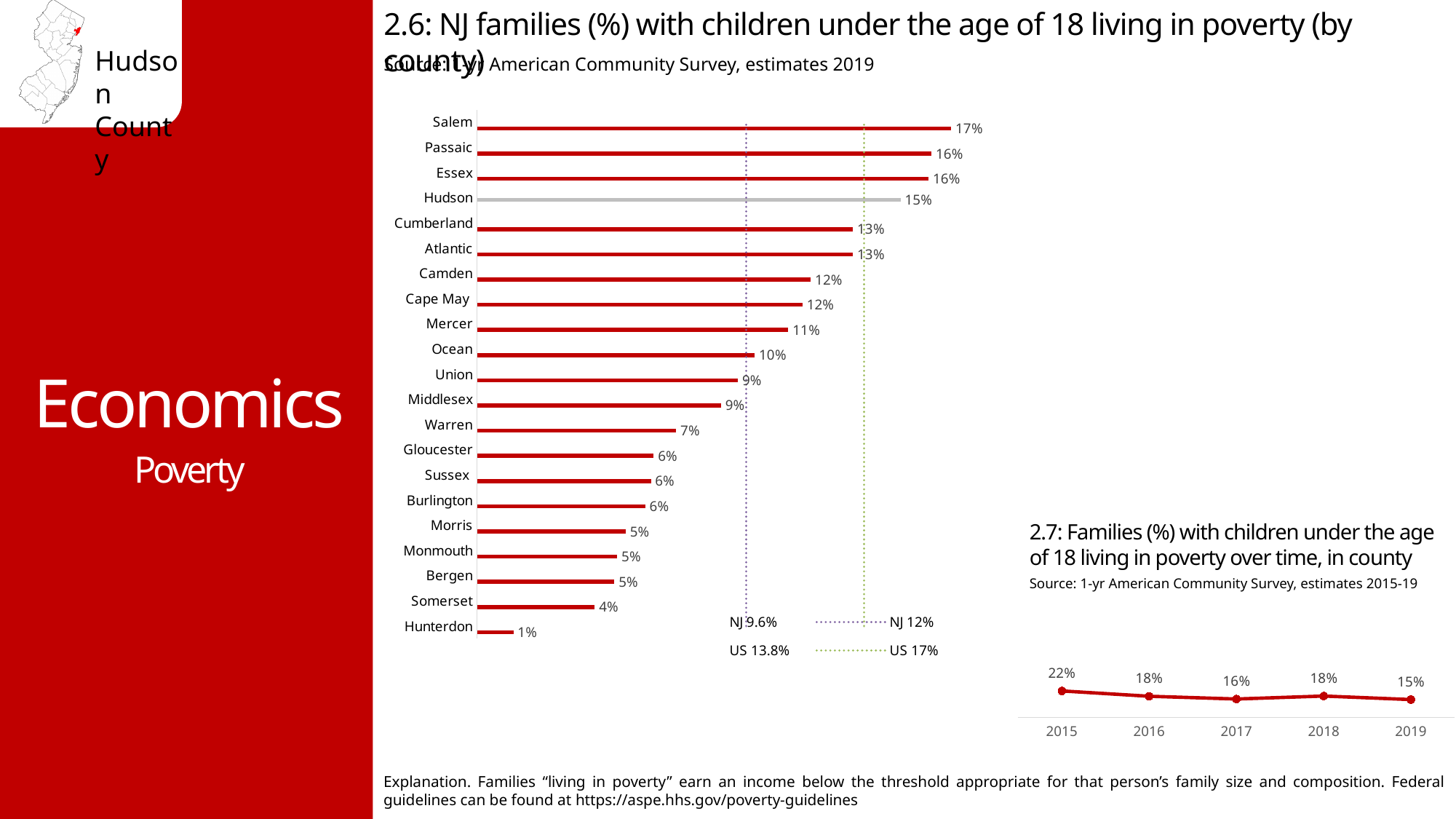
In chart 2.6, what is the difference between the values for Salem and Hunterdon? 16% In chart 2.6, what is the value for Somerset? 4% In chart 2.6, which county has the highest percentage of families with children living in poverty? Salem What kind of chart is chart 2.6? Bar chart In chart 2.6 (NJ families with children under 18 living in poverty by county), what is the value for Hudson? 15% In chart 2.6, which county has the lowest percentage of families with children living in poverty? Hunterdon In chart 2.7, what is the difference between the values for 2015 and 2019? 7% In chart 2.6, which has a higher value, Mercer or Warren? Mercer In chart 2.7, which year has the lowest value? 2019 In chart 2.7 (families with children under 18 living in poverty over time, in county), what is the value for 2015? 22% How many counties are plotted in chart 2.6? 21